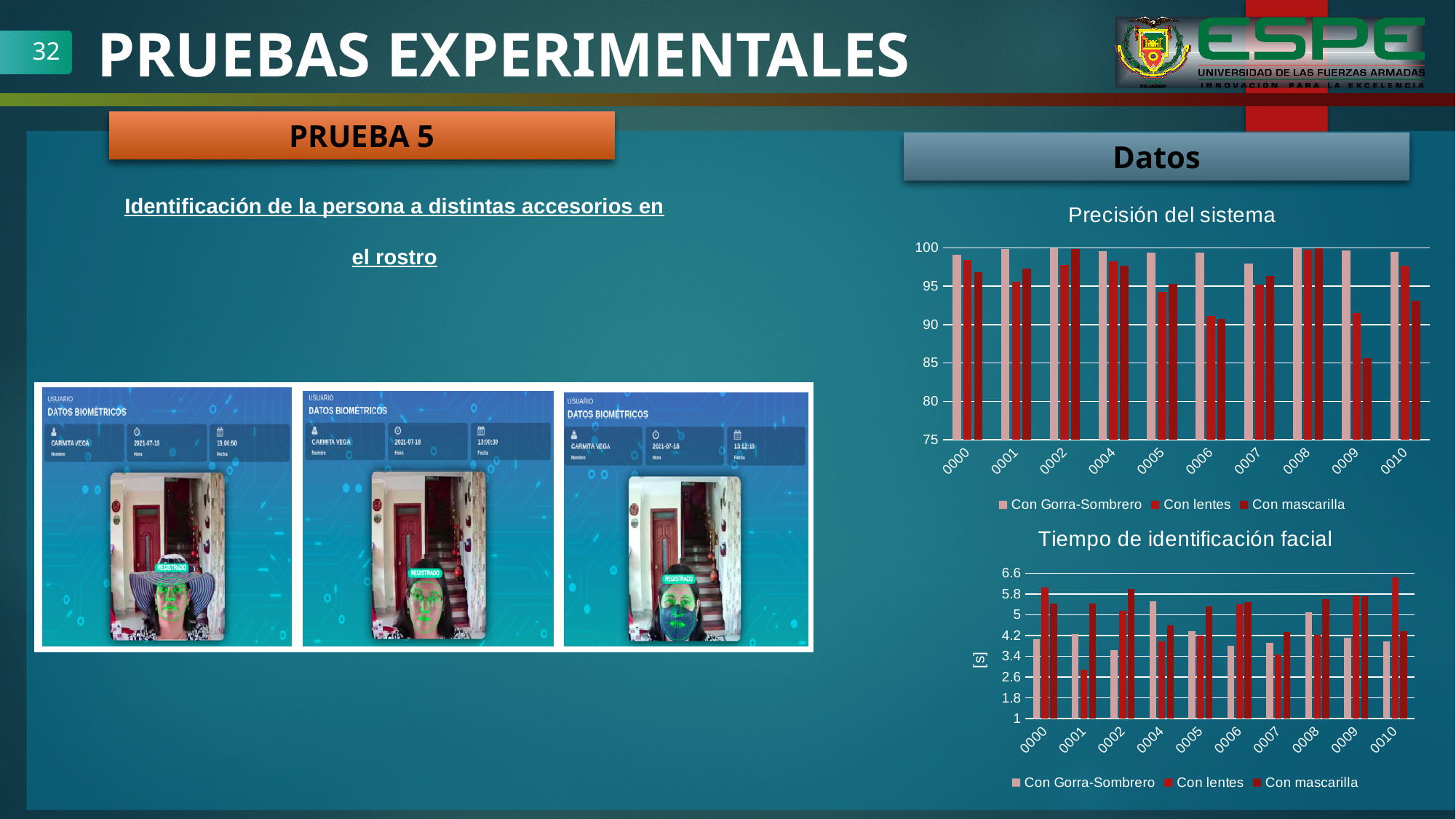
In the 'Precisión del sistema' chart, how many series does the legend list? 3 What is the y-axis label of the 'Tiempo de identificación facial' chart? [s] In the 'Precisión del sistema' chart, how many categories are shown on the x axis? 10 In the 'Tiempo de identificación facial' chart, is the value of 'Con lentes' for 0001 greater or less than 3.4? less In the 'Tiempo de identificación facial' chart, is the value of 'Con mascarilla' for 0010 greater or less than 5.8? less In the 'Precisión del sistema' chart, is the value of 'Con Gorra-Sombrero' for 0000 greater or less than 95? greater In the 'Tiempo de identificación facial' chart, for category 0001, which is larger: 'Con Gorra-Sombrero' or 'Con lentes'? Con Gorra-Sombrero In the 'Precisión del sistema' chart, for which category is the 'Con mascarilla' value lowest? 0009 What kind of chart is 'Tiempo de identificación facial'? Bar chart In the 'Precisión del sistema' chart, for category 0009, which is larger: 'Con Gorra-Sombrero' or 'Con mascarilla'? Con Gorra-Sombrero In the 'Tiempo de identificación facial' chart, for which category is the 'Con mascarilla' value highest? 0002